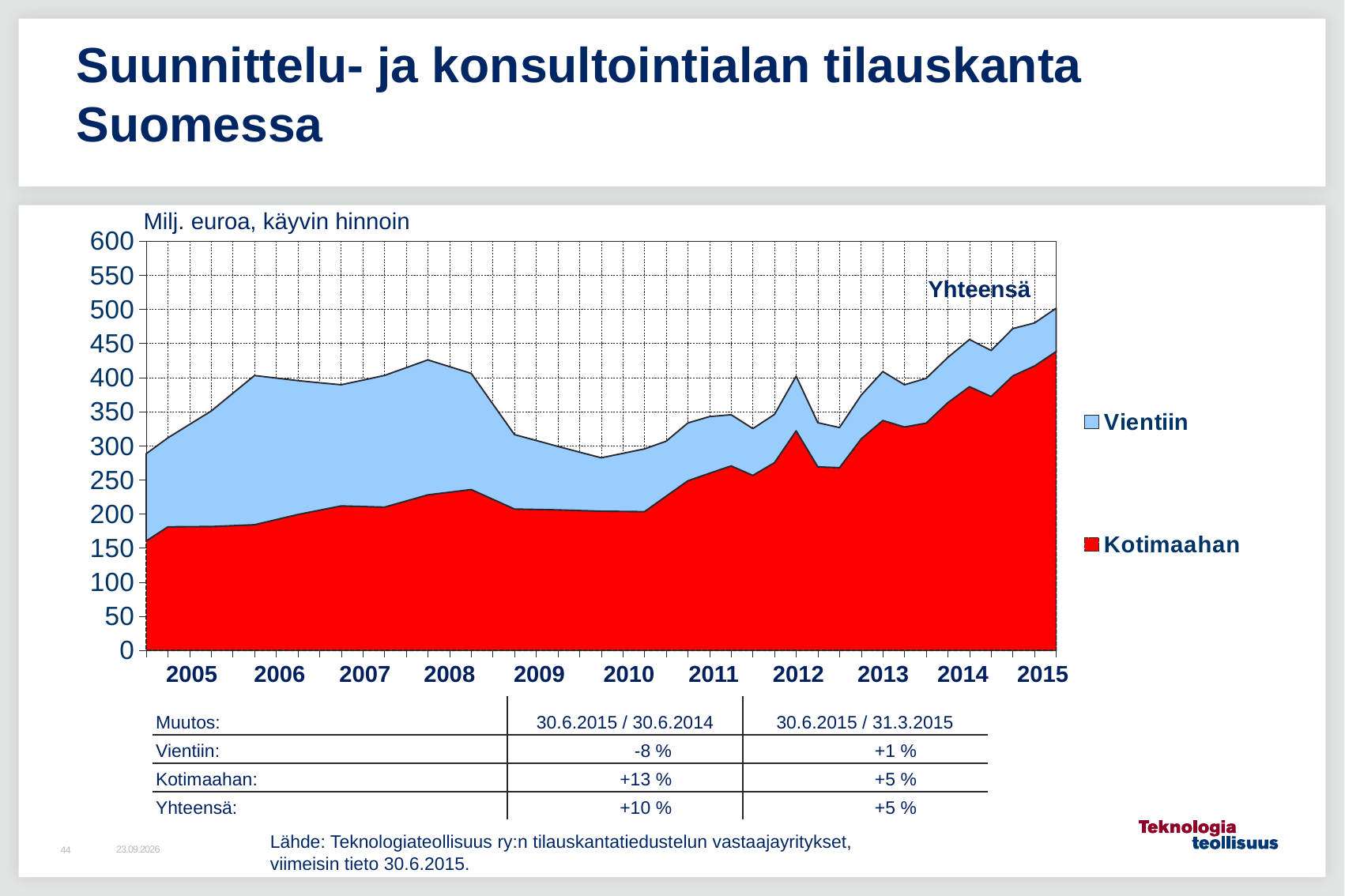
What unit is stated above the chart's vertical axis? Milj. euroa, käyvin hinnoin How many series does the chart legend list? 2 What kind of chart is shown on the slide? Stacked area chart Does the Kotimaahan series rise or fall between 2010 and 2015? rise Is the total (Yhteensä) value at 2010 greater or less than 350? less Is the total (Yhteensä) value at 2014 greater or less than 400? greater Which series occupies the lower (red) area of the chart? Kotimaahan Is the value for Kotimaahan at the end of 2015 greater or less than 400? greater Which two series are listed in the chart legend? Vientiin and Kotimaahan How many year labels are shown on the x axis? 11